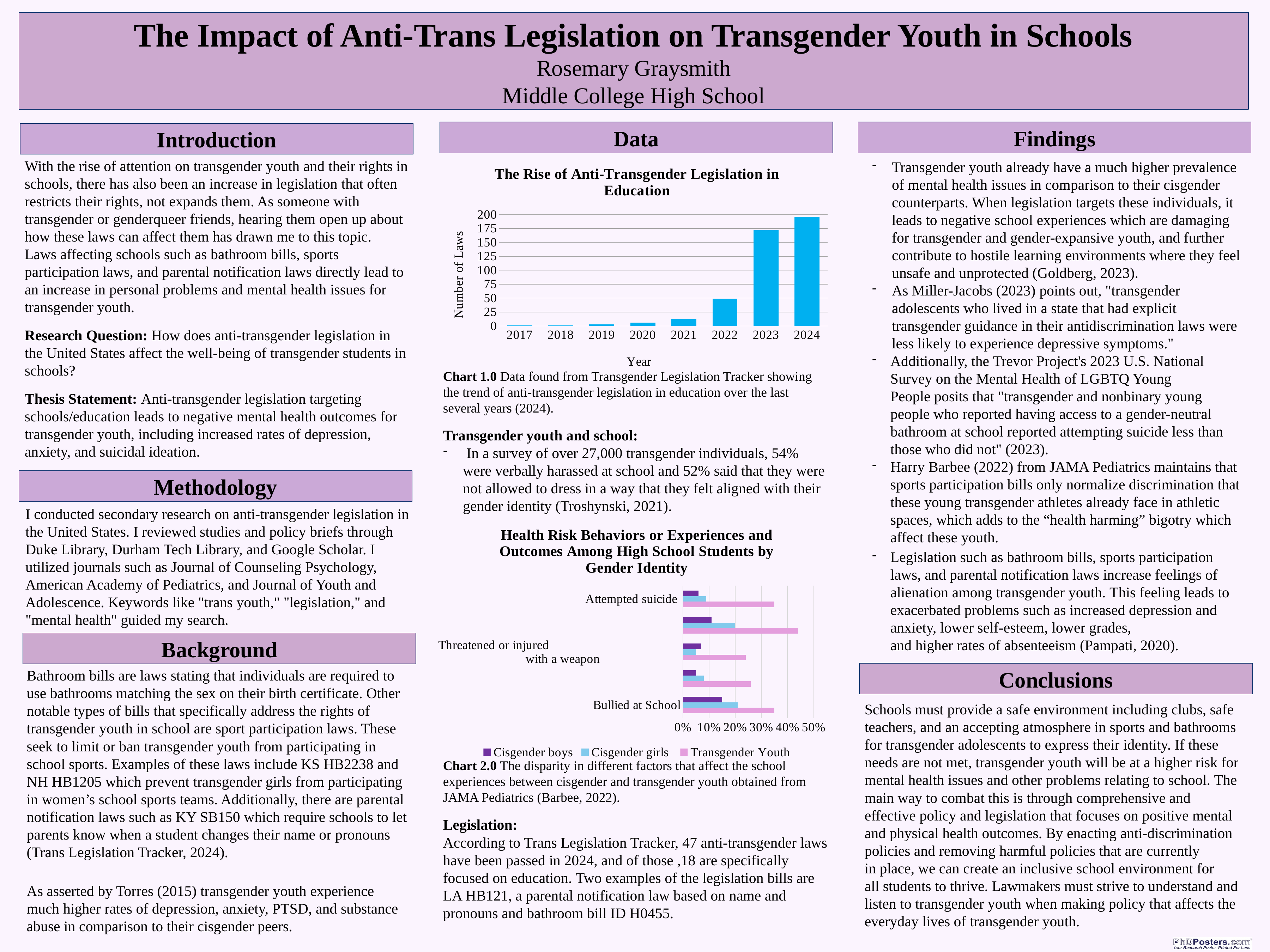
In 'The Rise of Anti-Transgender Legislation in Education', is the value for 2022 greater or less than 75? less In 'The Rise of Anti-Transgender Legislation in Education', which year has the highest number of laws? 2024 In 'The Rise of Anti-Transgender Legislation in Education', do the values rise or fall from 2017 to 2024? rise What is the y-axis label of 'The Rise of Anti-Transgender Legislation in Education'? Number of Laws In 'The Rise of Anti-Transgender Legislation in Education', is the value for 2023 greater or less than 150? greater In 'Health Risk Behaviors or Experiences and Outcomes Among High School Students by Gender Identity', which group has the highest value for Attempted suicide? Transgender Youth In 'Health Risk Behaviors or Experiences and Outcomes Among High School Students by Gender Identity', is the Transgender Youth value for Bullied at School greater or less than 30%? greater What kind of chart is 'The Rise of Anti-Transgender Legislation in Education'? bar chart How many series does the legend list in 'Health Risk Behaviors or Experiences and Outcomes Among High School Students by Gender Identity'? 3 In 'The Rise of Anti-Transgender Legislation in Education', which year has the larger value, 2022 or 2023? 2023 How many years are shown on the x axis of 'The Rise of Anti-Transgender Legislation in Education'? 8 What kind of chart is 'Health Risk Behaviors or Experiences and Outcomes Among High School Students by Gender Identity'? bar chart